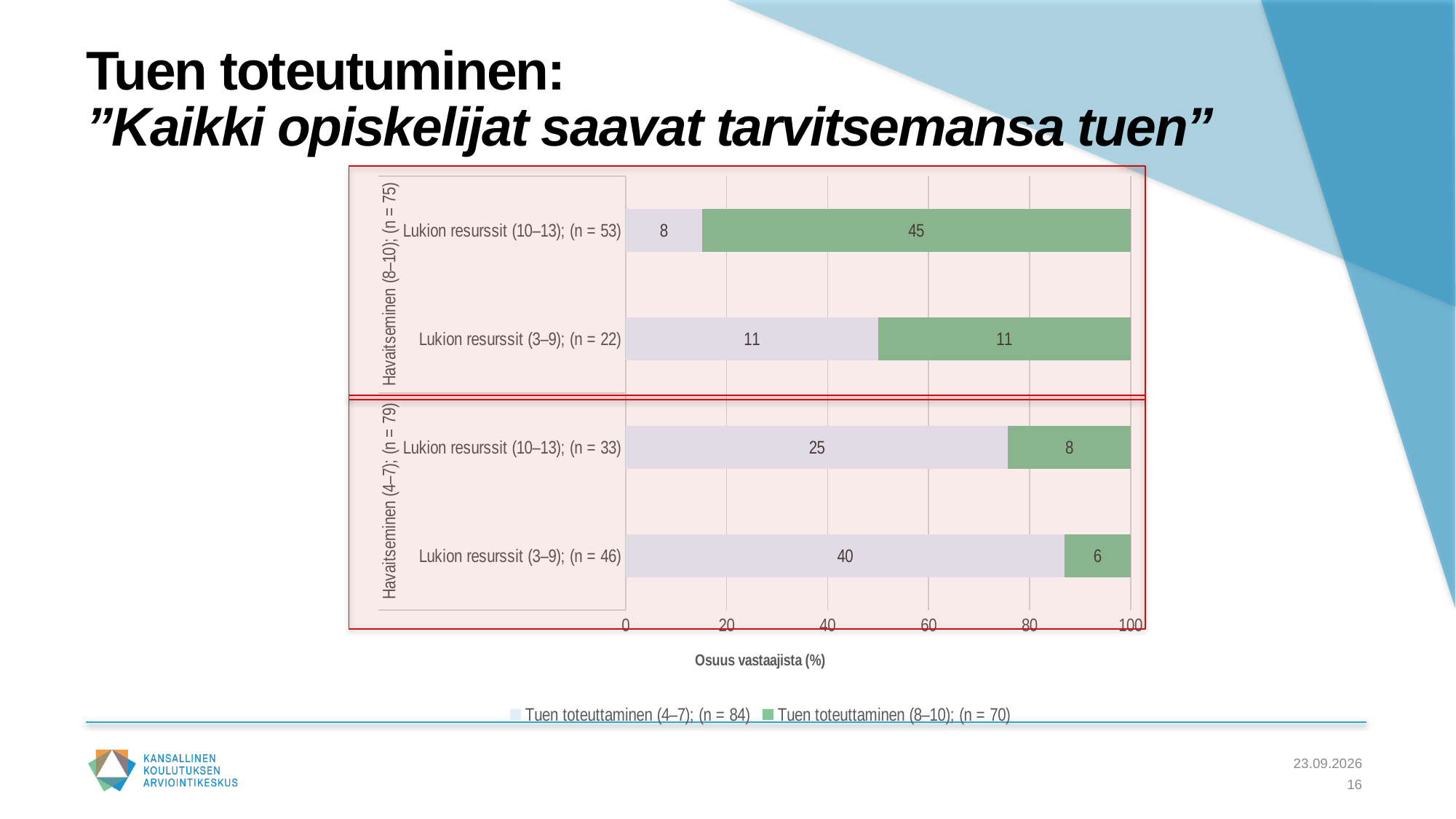
What is the data label for the 'Tuen toteuttaminen (4–7)' segment of the bar 'Lukion resurssit (3–9); (n = 46)'? 40 What is the difference between the two data labels in the bar 'Lukion resurssit (3–9); (n = 46)'? 34 What is the x-axis title of the chart? Osuus vastaajista (%) How many series does the legend list? 2 What is the data label for the 'Tuen toteuttaminen (4–7)' segment of the bar 'Lukion resurssit (10–13); (n = 33)'? 25 In the bar 'Lukion resurssit (10–13); (n = 33)', which segment has the larger data label, 'Tuen toteuttaminen (4–7)' or 'Tuen toteuttaminen (8–10)'? Tuen toteuttaminen (4–7) Which bar has the largest single segment data label? Lukion resurssit (10–13); (n = 53) What is the data label for the 'Tuen toteuttaminen (8–10)' segment of the bar 'Lukion resurssit (3–9); (n = 22)'? 11 What kind of chart is shown on the slide? stacked bar chart What is the sum of the two data labels in the bar 'Lukion resurssit (10–13); (n = 33)'? 33 What is the data label for the 'Tuen toteuttaminen (8–10)' segment of the bar 'Lukion resurssit (10–13); (n = 53)'? 45 How many category bars are plotted in the chart? 4